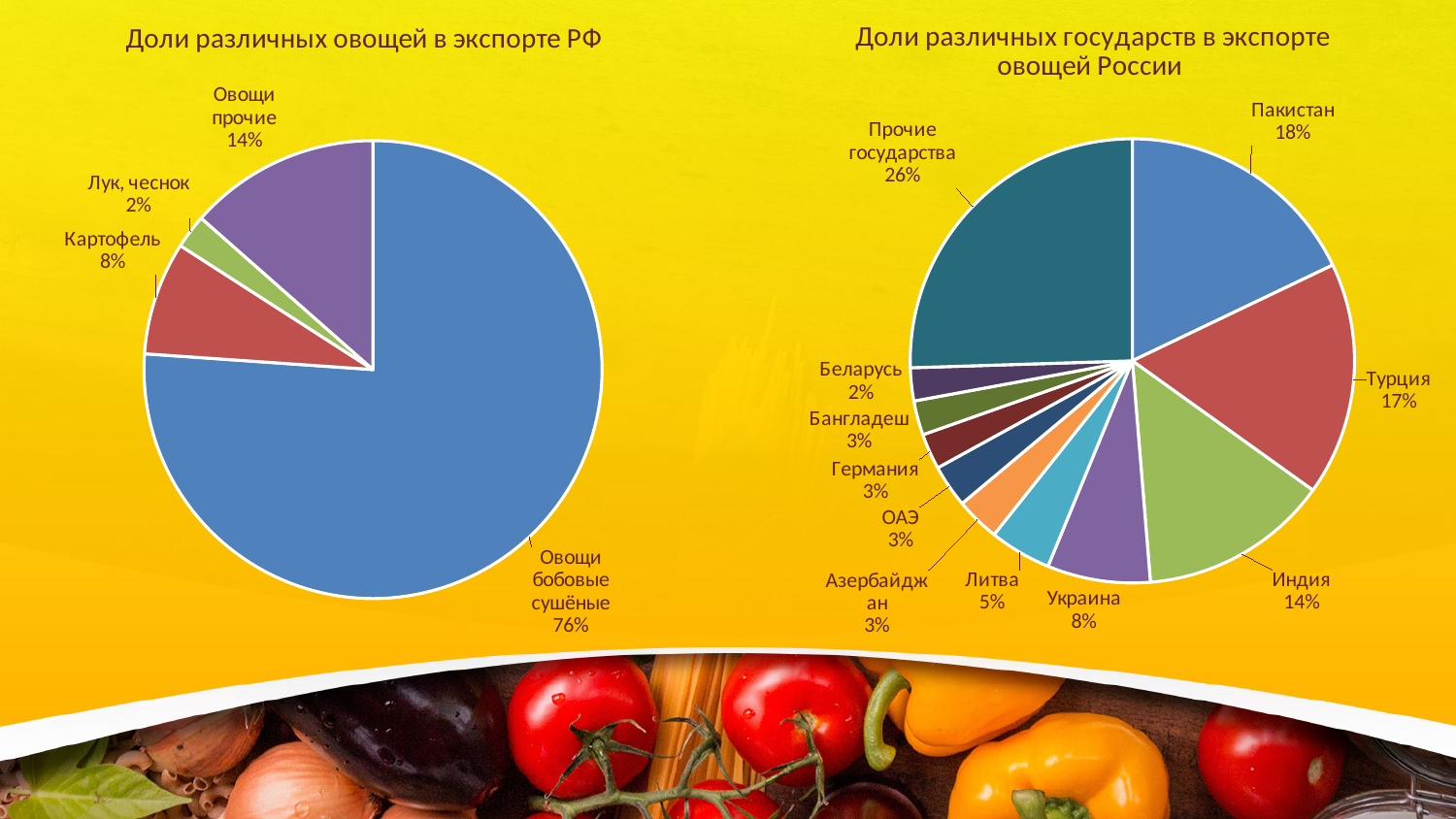
In the chart 'Доли различных государств в экспорте овощей России', what is the share of 'Прочие государства'? 26% In the chart 'Доли различных государств в экспорте овощей России', how many slices does the pie have? 11 In the chart 'Доли различных овощей в экспорте РФ', which category has the smallest share? Лук, чеснок In the chart 'Доли различных овощей в экспорте РФ', what is the share of 'Картофель'? 8% In the chart 'Доли различных государств в экспорте овощей России', which is larger: the share of Индия or the share of Украина? Индия In the chart 'Доли различных государств в экспорте овощей России', which named country (excluding 'Прочие государства') has the largest share? Пакистан In the chart 'Доли различных овощей в экспорте РФ', what share do 'Овощи бобовые сушёные' have? 76% In the chart 'Доли различных государств в экспорте овощей России', what is the share of Пакистан? 18% In the chart 'Доли различных государств в экспорте овощей России', what is the difference between the shares of Турция and Литва? 12% What type of chart is used on the left side of the slide? Pie chart In the chart 'Доли различных овощей в экспорте РФ', what is the difference between the shares of 'Овощи прочие' and 'Картофель'? 6% In the chart 'Доли различных овощей в экспорте РФ', how many slices does the pie have? 4